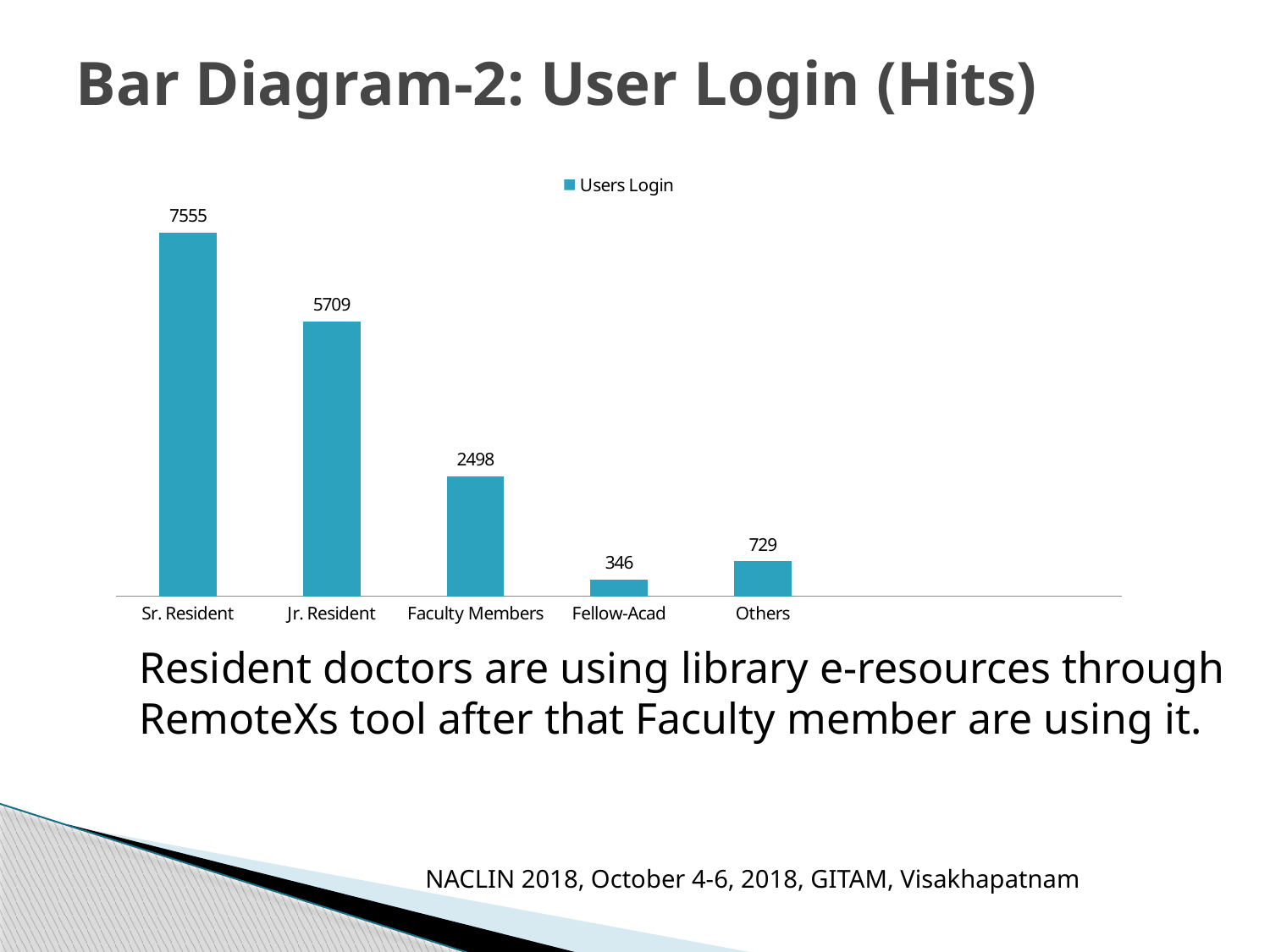
What is the difference between the Users Login values for Others and Fellow-Acad? 383 What is the Users Login value for Faculty Members? 2498 Which category has the highest Users Login value? Sr. Resident What is the Users Login value for Others? 729 What kind of chart is shown on the slide? Bar chart What is the legend entry shown for the chart? Users Login Which has a larger Users Login value, Faculty Members or Others? Faculty Members Which category has the lowest Users Login value? Fellow-Acad What is the Users Login value for Fellow-Acad? 346 What is the difference between the Users Login values for Sr. Resident and Jr. Resident? 1846 What is the Users Login value for Sr. Resident? 7555 How many categories are shown on the x axis of the chart? 5